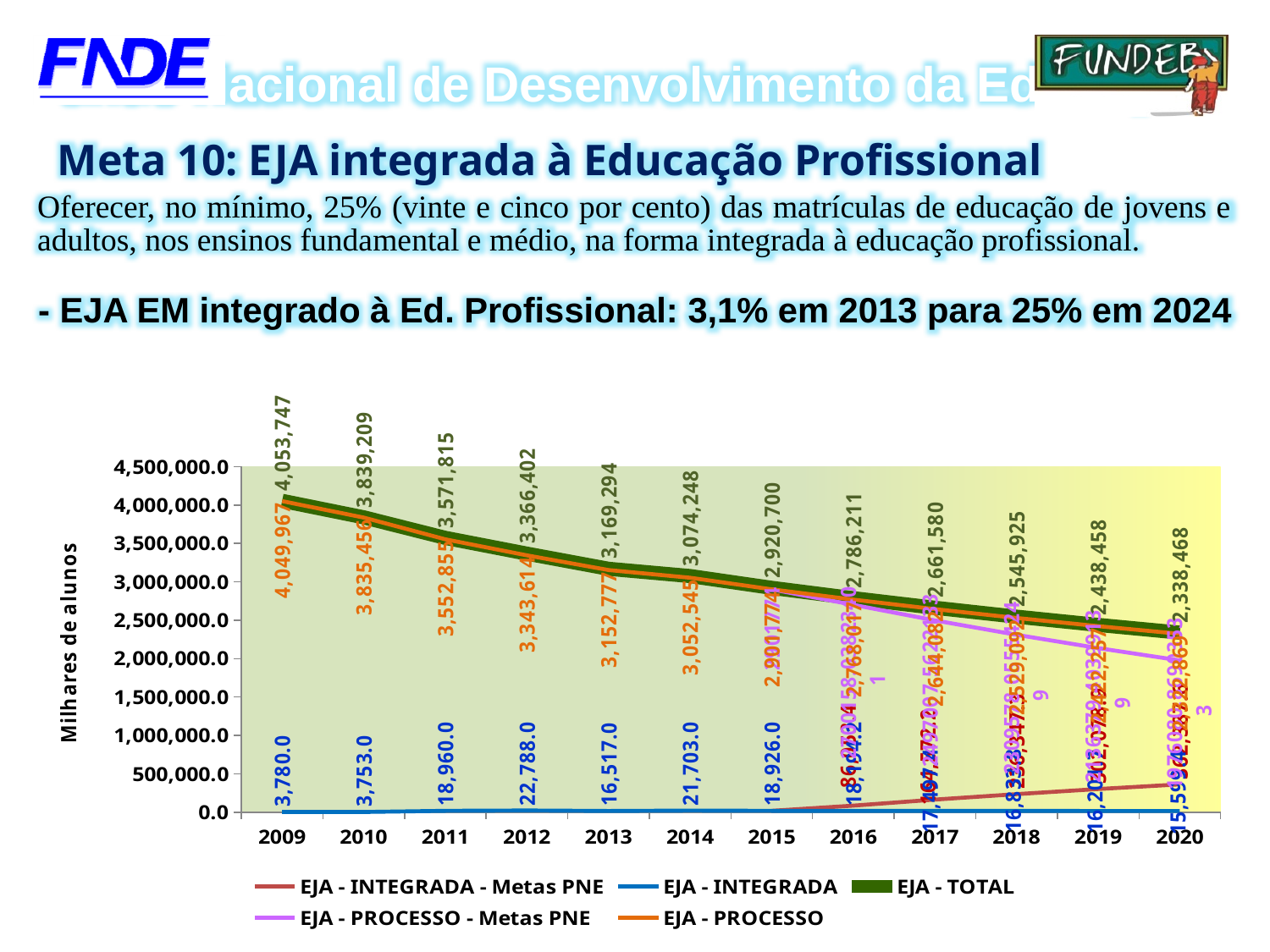
How many years are plotted along the x axis of the chart? 12 What is the value of EJA - TOTAL in 2020? 2,338,468 What is the value of EJA - TOTAL in 2009? 4,053,747 What is the label on the y axis of the chart? Milhares de alunos What kind of chart is shown on the slide? Line chart What is the value of EJA - PROCESSO in 2013? 3,152,777 How many series does the chart legend list? 5 In which year is EJA - TOTAL lowest? 2020 In which year is EJA - TOTAL highest? 2009 Does EJA - TOTAL rise or fall from 2009 to 2020? Fall What is the difference between EJA - TOTAL in 2009 and in 2010? 214,538 What is the value of EJA - INTEGRADA in 2012? 22,788.0